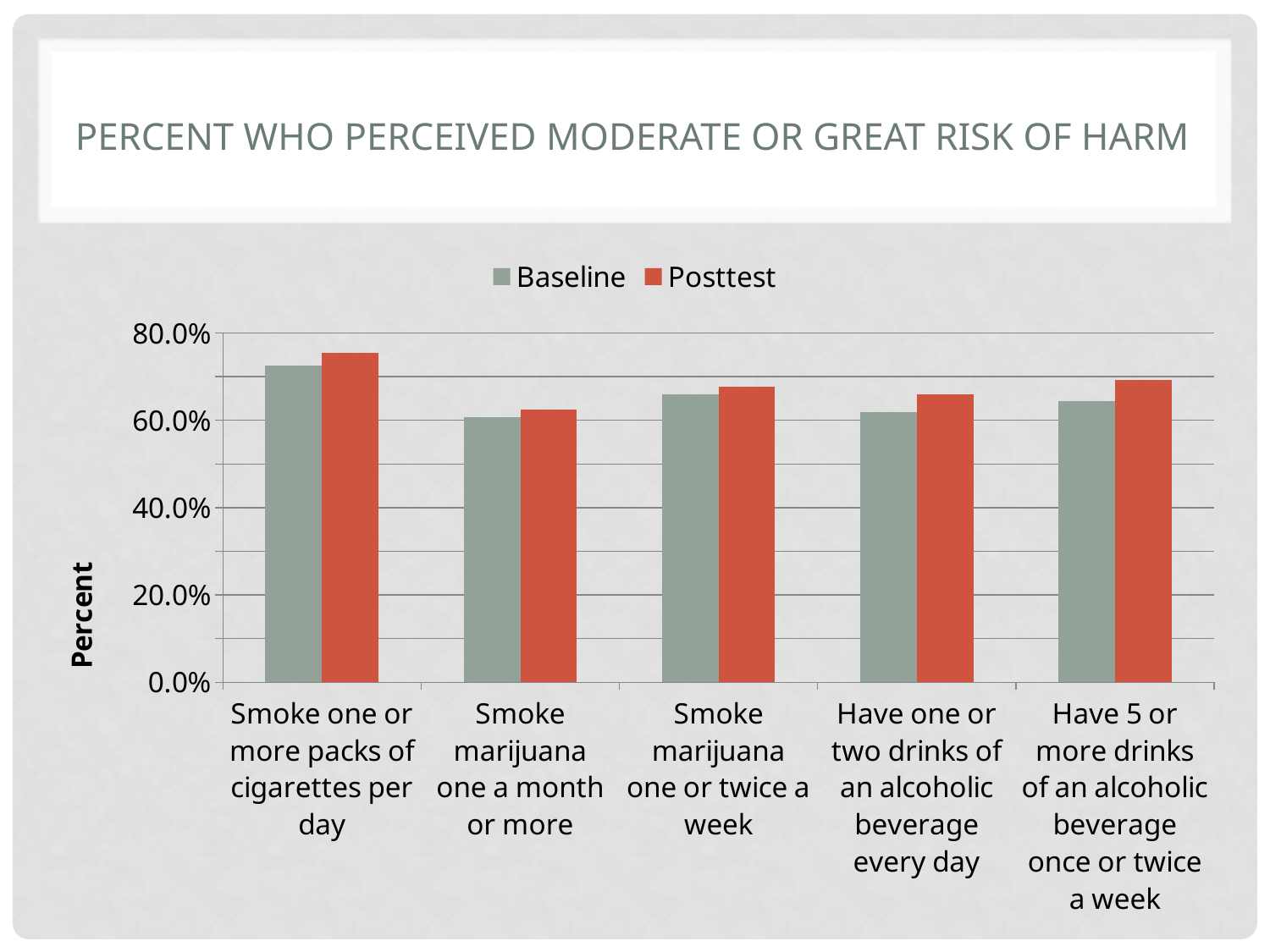
What kind of chart is shown on the slide? Bar chart What is the title of the chart? Percent who perceived moderate or great risk of harm Which category has the highest Baseline value? Smoke one or more packs of cigarettes per day How many categories are shown along the x axis? 5 For 'Smoke one or more packs of cigarettes per day', which is larger, the Baseline or the Posttest value? Posttest How many series does the legend list? 2 What is the label on the vertical axis? Percent Is the Baseline value for 'Smoke one or more packs of cigarettes per day' greater or less than 60.0%? greater Which category has the lowest Posttest value? Smoke marijuana one a month or more Is the Posttest value for 'Have one or two drinks of an alcoholic beverage every day' greater or less than 80.0%? less For 'Have 5 or more drinks of an alcoholic beverage once or twice a week', which is larger, the Baseline or the Posttest value? Posttest Which category has the highest Posttest value? Smoke one or more packs of cigarettes per day